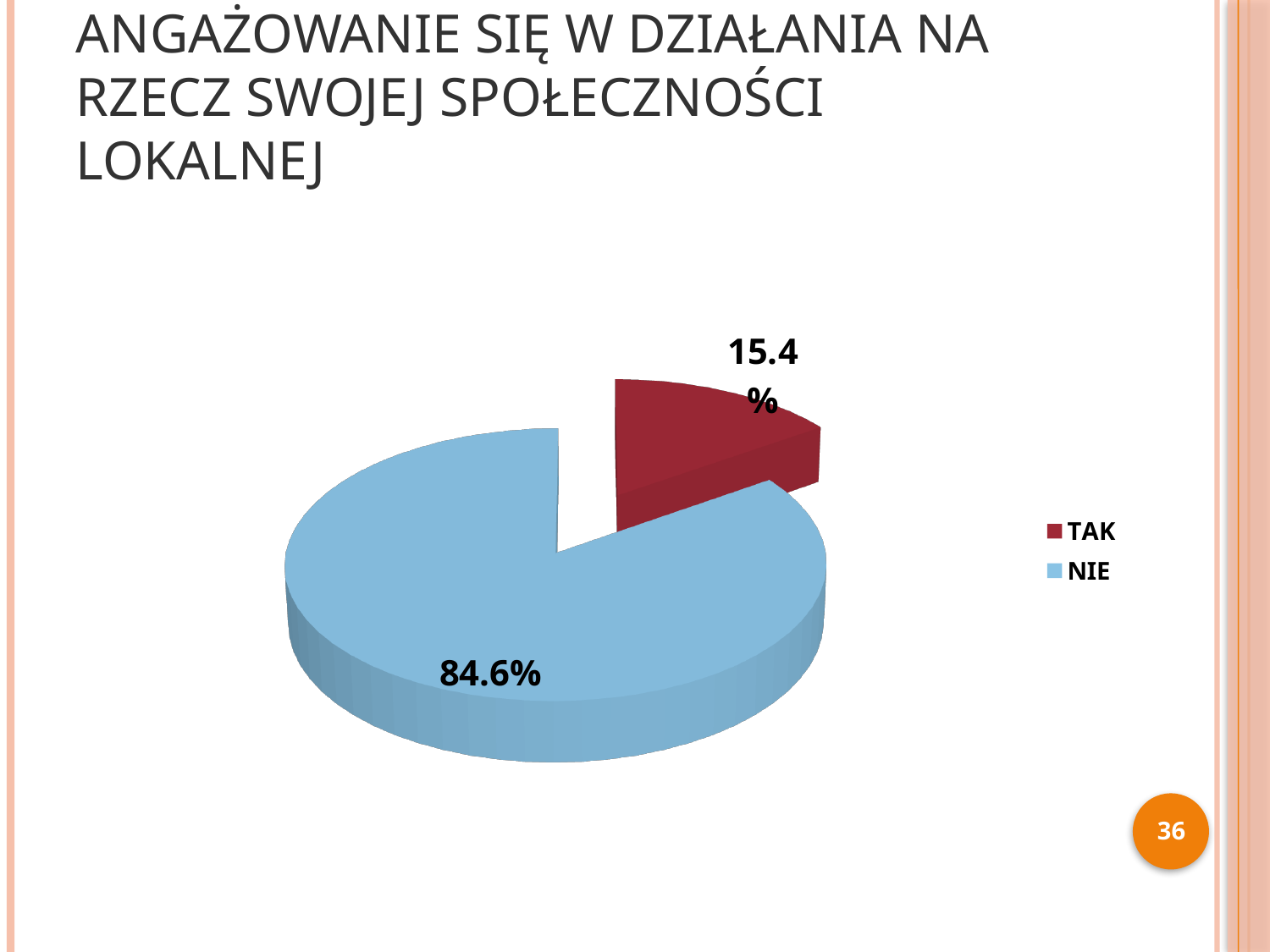
Which slice is larger, TAK or NIE? NIE Which category has the largest slice of the pie? NIE What share of the pie does the TAK slice represent? 15.4% What colour is the NIE slice? light blue What kind of chart is shown on the slide? pie chart What colour is the TAK slice? dark red How many slices does the pie chart have? 2 What is the difference in percentage points between the NIE and TAK slices? 69.2 Which category has the smallest slice of the pie? TAK How many entries does the legend list? 2 What share of the pie does the NIE slice represent? 84.6%